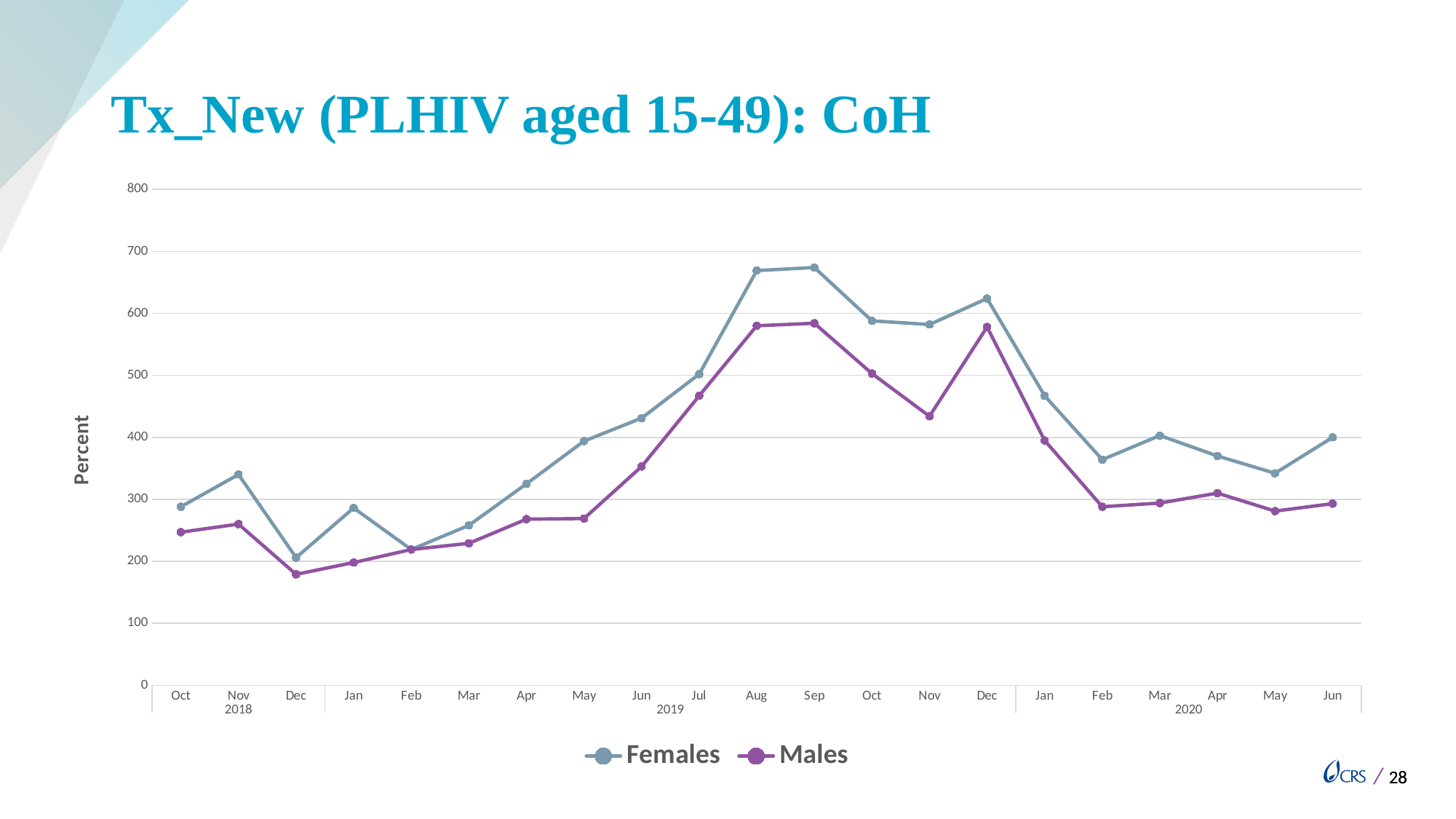
In which month is the Males value lowest? Dec 2018 In which month is the Females value lowest? Dec 2018 Which two series are shown in the legend? Females and Males Is the Males value for Dec 2018 greater or less than 200? less In Aug 2019, which series has the higher value, Females or Males? Females How many monthly data points are plotted along the x axis for each series? 21 How many series does the legend list? 2 Is the Females value for Aug 2019 greater or less than 600? greater Is the Males value for Nov 2019 greater or less than 400? greater Do the Females values rise or fall from Sep 2019 to Oct 2019? fall What kind of chart is shown on the slide? Line chart What is the label on the vertical axis? Percent